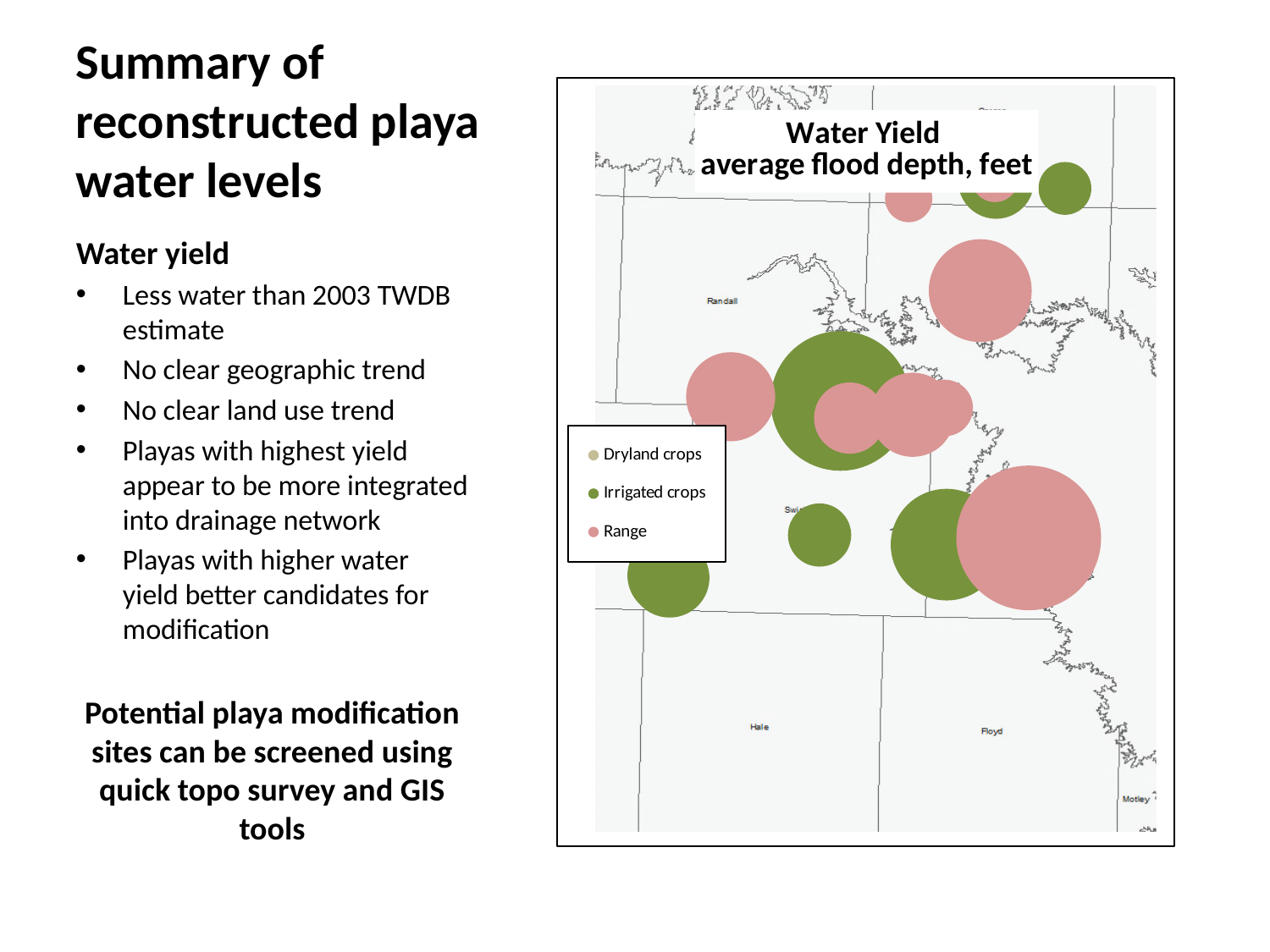
What is the title of the chart on the right side of the slide? Water Yield average flood depth, feet What are the three legend entries of the Water Yield chart? Dryland crops, Irrigated crops, Range What unit is the water yield measured in, according to the chart title? feet Which land use category does the largest bubble on the Water Yield chart belong to? Range How many series does the legend of the Water Yield chart list? 3 What kind of chart is shown on the map on the right side of the slide? bubble chart